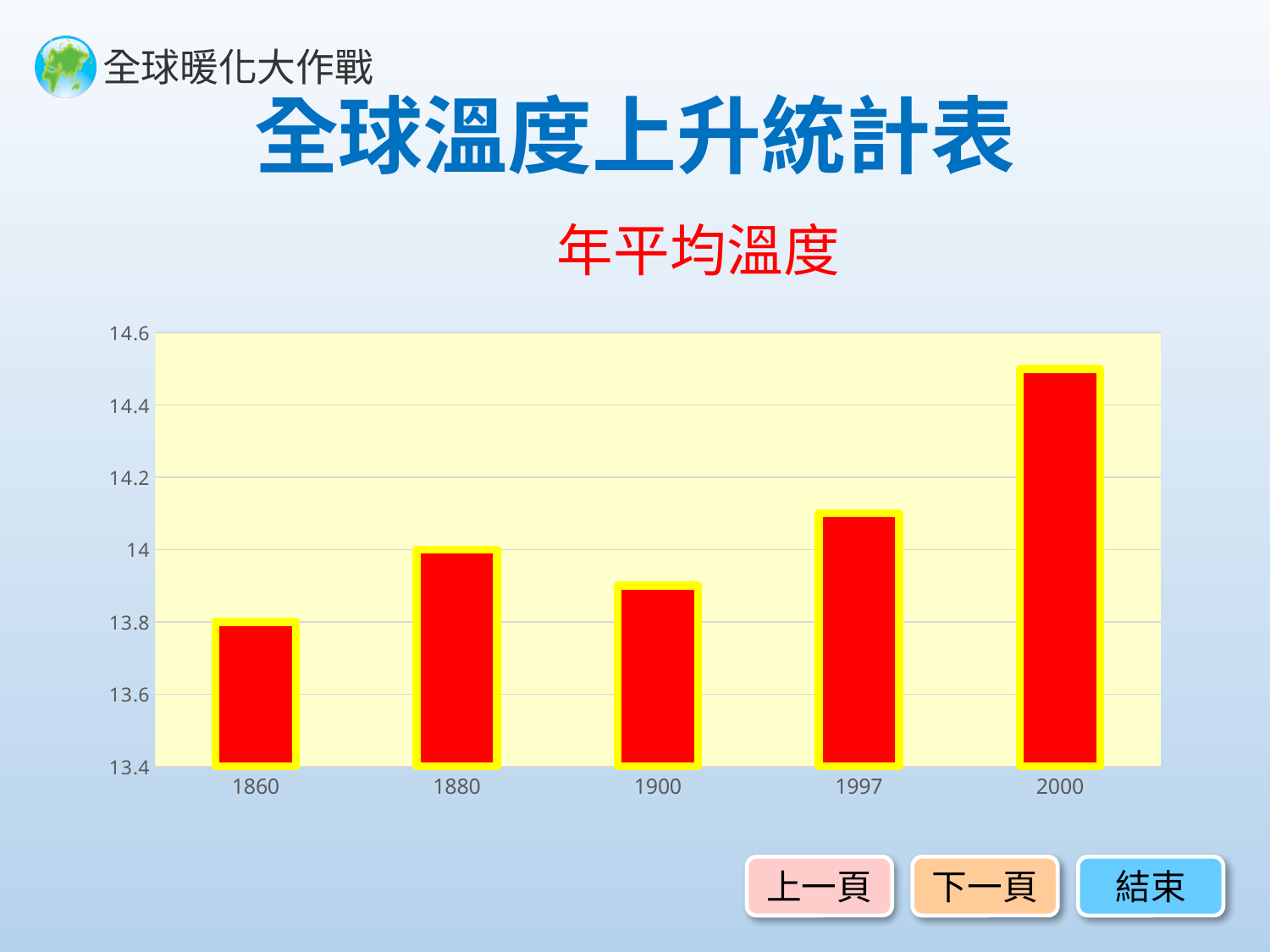
What kind of chart is shown on the slide? bar chart Overall, do the values rise or fall from 1860 to 2000? rise Is the value for 1860 greater or less than 14? less Is the value for 1900 greater or less than 14? less Is the value for 2000 greater or less than 14.4? greater Which year has the larger value, 1997 or 1900? 1997 How many years are shown on the x axis of the chart? 5 Which year has the highest average temperature in the chart? 2000 What is the title shown above the chart? 年平均溫度 Which year has the lowest average temperature in the chart? 1860